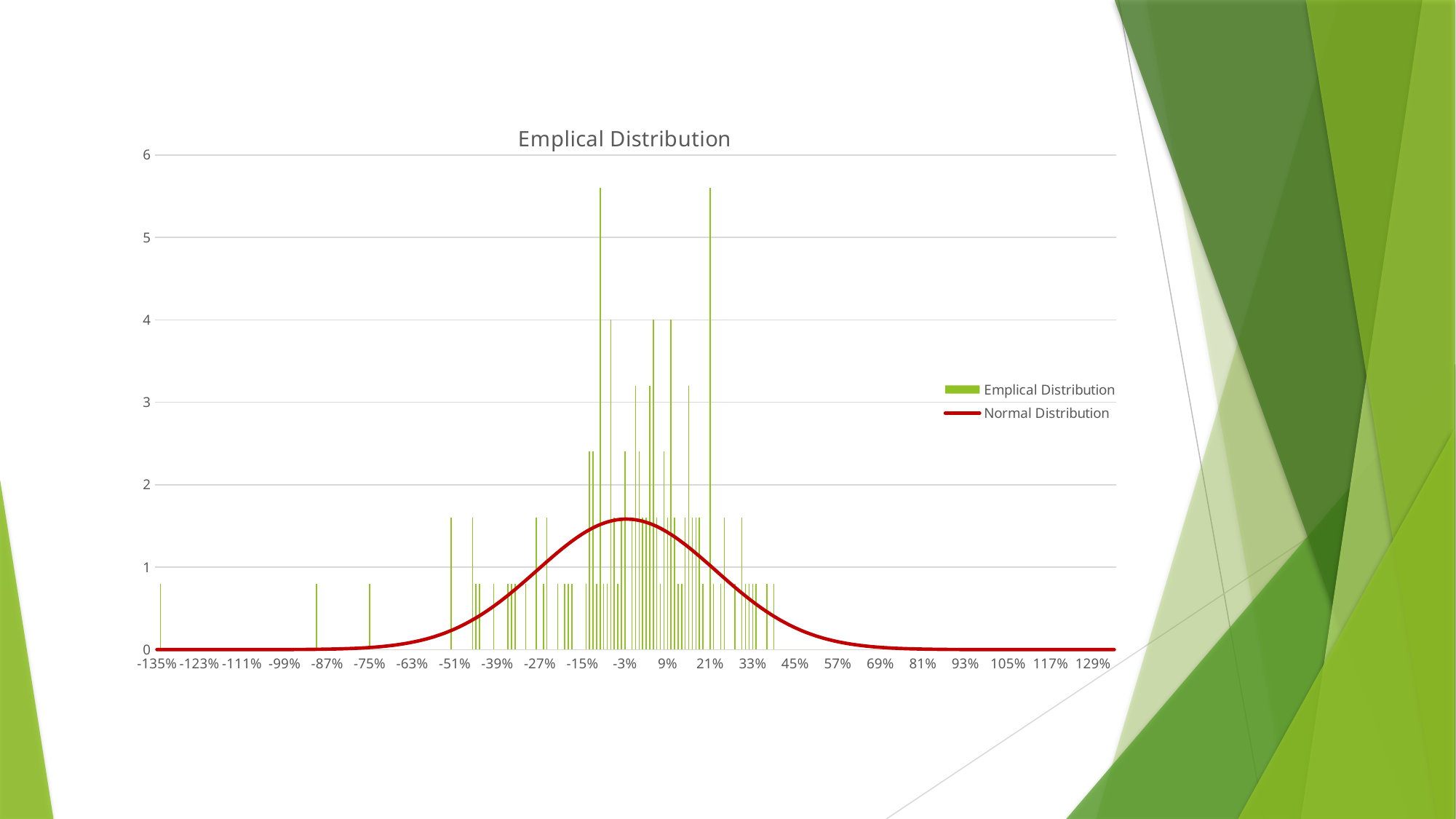
What is the title of the chart? Emplical Distribution What kind of chart is shown on the slide? combination bar and line chart Which series is drawn as a red line? Normal Distribution Is the Emplical Distribution bar at -87% greater or less than 1? less How many series does the legend list? 2 Is the peak of the Normal Distribution line greater or less than 2? less Is the Emplical Distribution bar at -51% greater or less than 1? greater How many labels are shown on the x axis? 23 Does the Normal Distribution line rise or fall between -3% and 45%? fall Does the Normal Distribution line rise or fall between -63% and -3%? rise